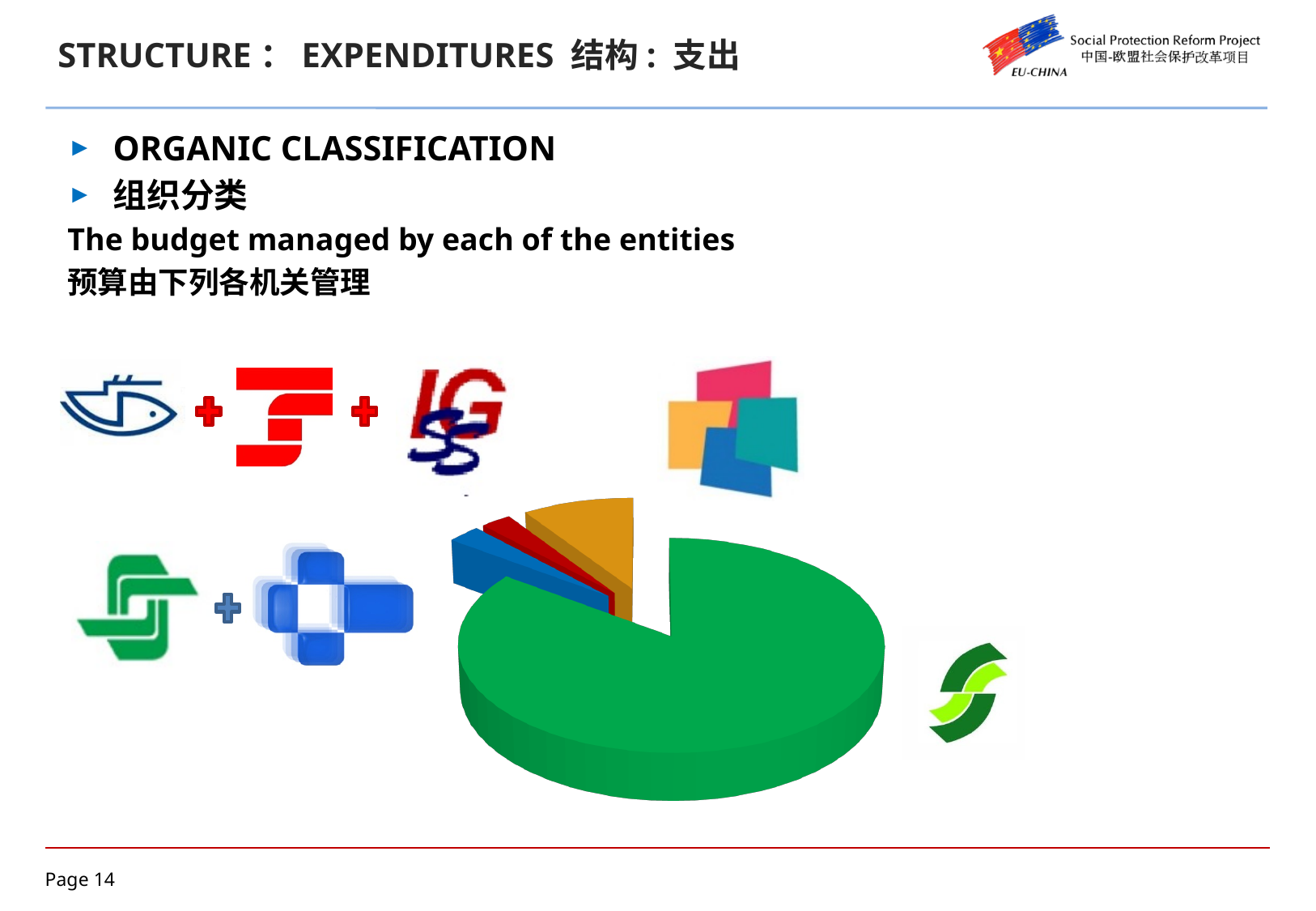
Which is larger in the pie chart, the orange slice or the red slice? orange Which is larger in the pie chart, the orange slice or the blue slice? orange Which is larger in the pie chart, the green slice or the orange slice? green Which colour slice is the largest in the pie chart? green Does the pie chart have a legend? No How many slices does the pie chart have? 4 What kind of chart is shown on the slide? pie chart Is the pie chart drawn in 3D? Yes